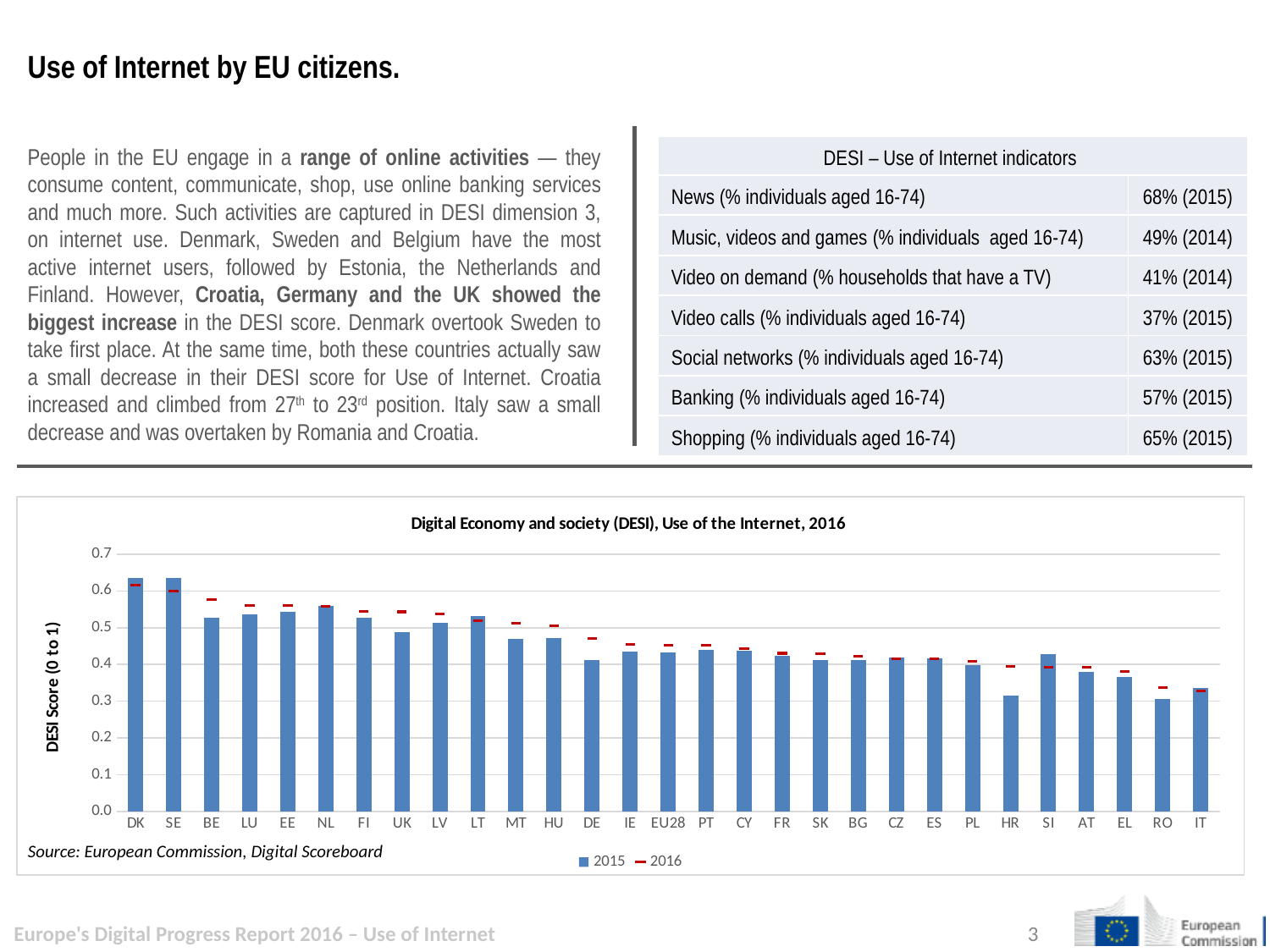
Is the 2015 value for DK greater or less than 0.6? greater Do the 2015 values generally rise or fall moving from left to right along the x axis? fall Is the 2015 value for BE greater or less than 0.5? greater Which has the larger 2015 value, DK or IT? DK What is the title of the chart? Digital Economy and society (DESI), Use of the Internet, 2016 What is the label of the vertical axis of the chart? DESI Score (0 to 1) How many series does the legend of the chart list? 2 How many countries/categories are shown along the x axis of the chart? 29 Is the 2015 value for HR greater or less than 0.4? less What type of chart is shown on the slide? bar chart